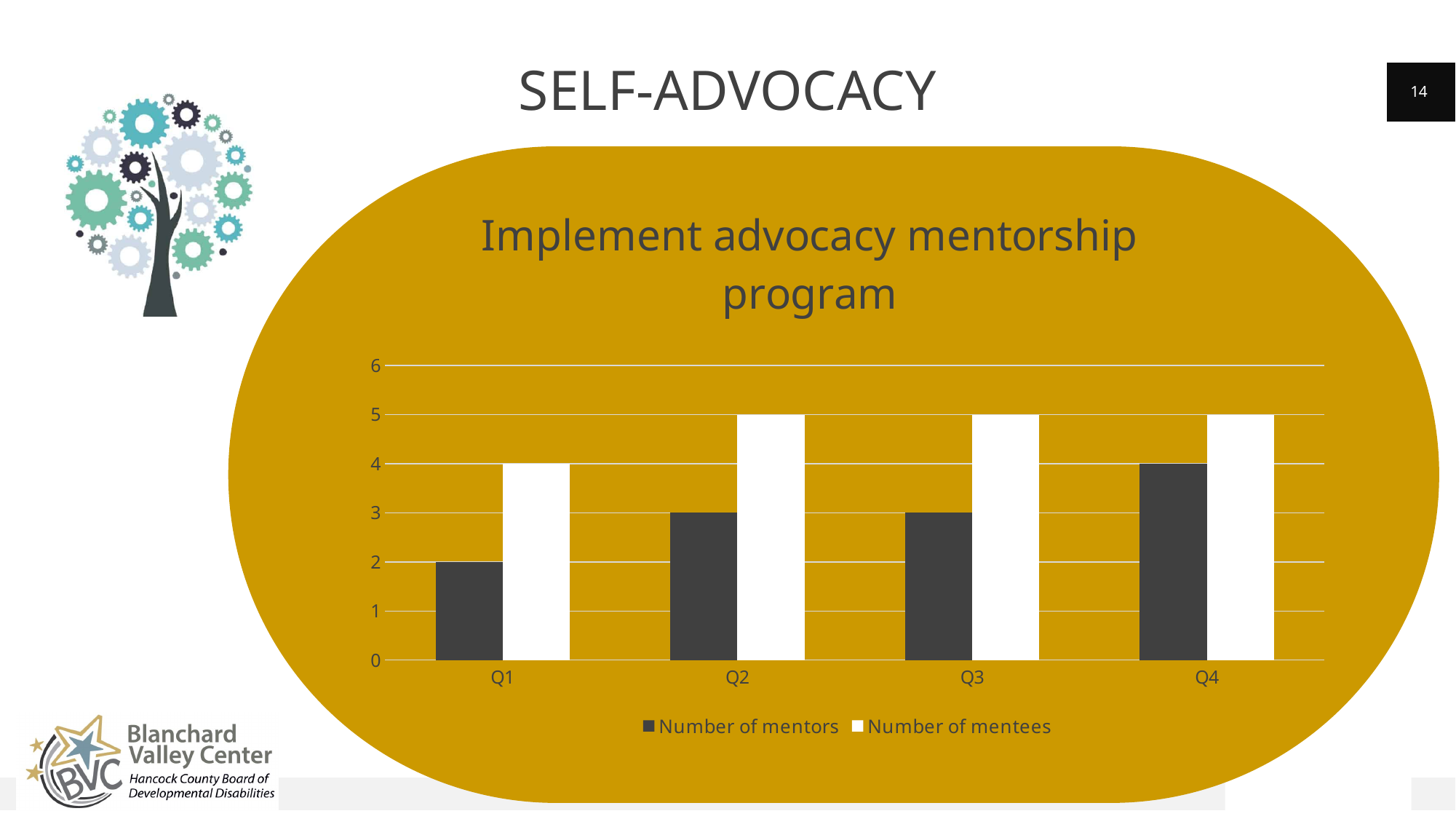
How many quarters are shown on the x axis of the chart? 4 What is the number of mentors in Q1? 2 In which quarter is the number of mentors highest? Q4 Does the number of mentors rise or fall from Q1 to Q4? Rise What is the number of mentors in Q4? 4 What is the number of mentees in Q1? 4 Which is larger in Q3, the number of mentors or the number of mentees? Number of mentees In which quarter is the number of mentors lowest? Q1 What is the difference between the number of mentees and the number of mentors in Q1? 2 What is the number of mentees in Q2? 5 What type of chart is shown on the slide? Bar chart How many series does the chart legend list? 2